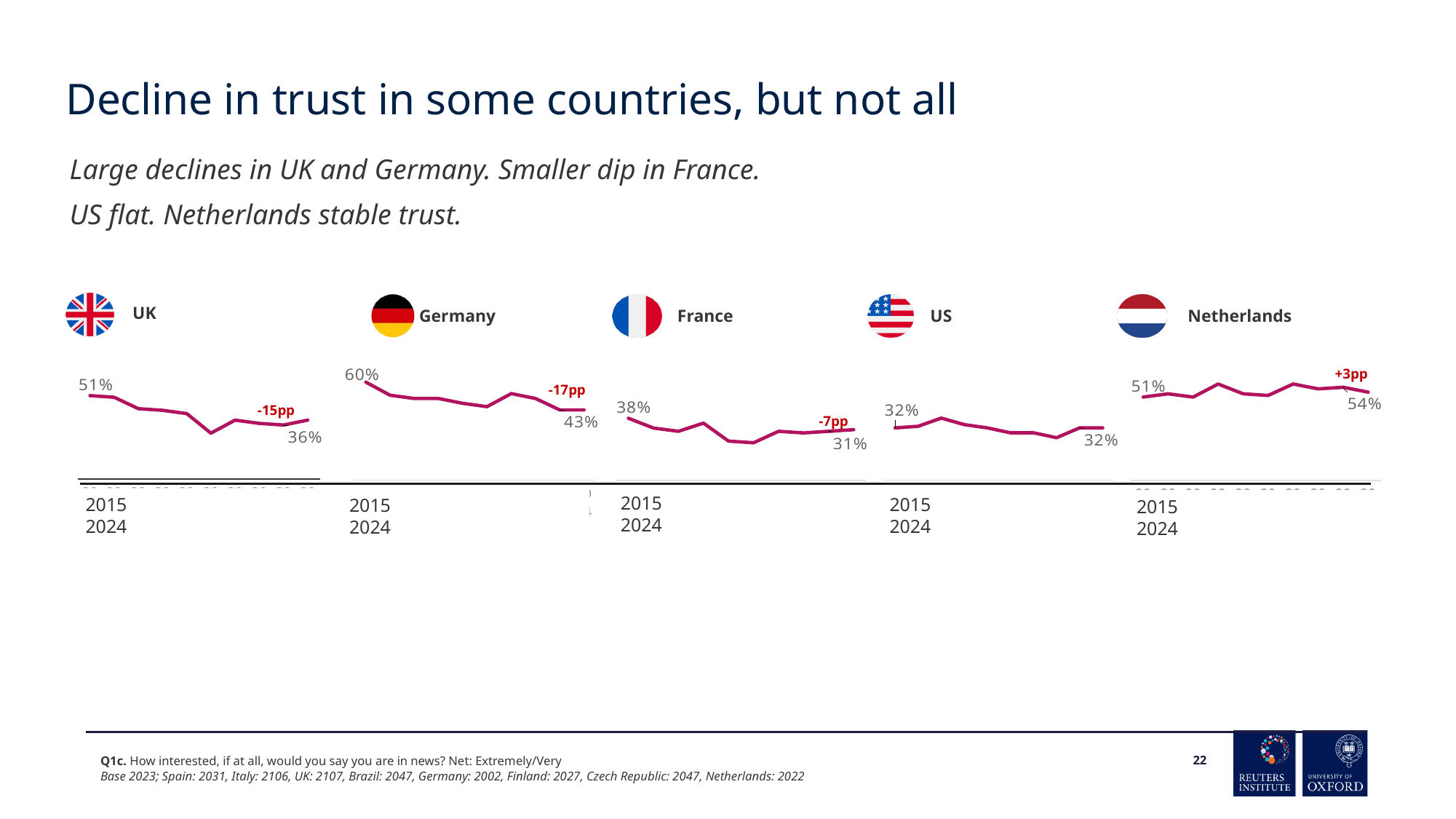
In the Germany chart, do the values rise or fall from 2015 to 2024? fall Across the five charts, which country has the highest 2015 value? Germany In the UK chart, what is the value shown for 2015? 51% In the Netherlands chart, what is the value shown for 2024? 54% In the Germany chart, what is the value shown for 2015? 60% In the France chart, what is the value shown for 2024? 31% What kind of chart is used for each country on the slide? line chart In the UK chart, what is the value shown for 2024? 36% Across the five charts, which country has the lowest 2024 value? France In the Netherlands chart, what is the difference between the 2024 value and the 2015 value? 3 percentage points In the US chart, is the 2024 value larger than, smaller than, or equal to the 2015 value? equal In the Germany chart, what change in percentage points is annotated on the line? -17pp